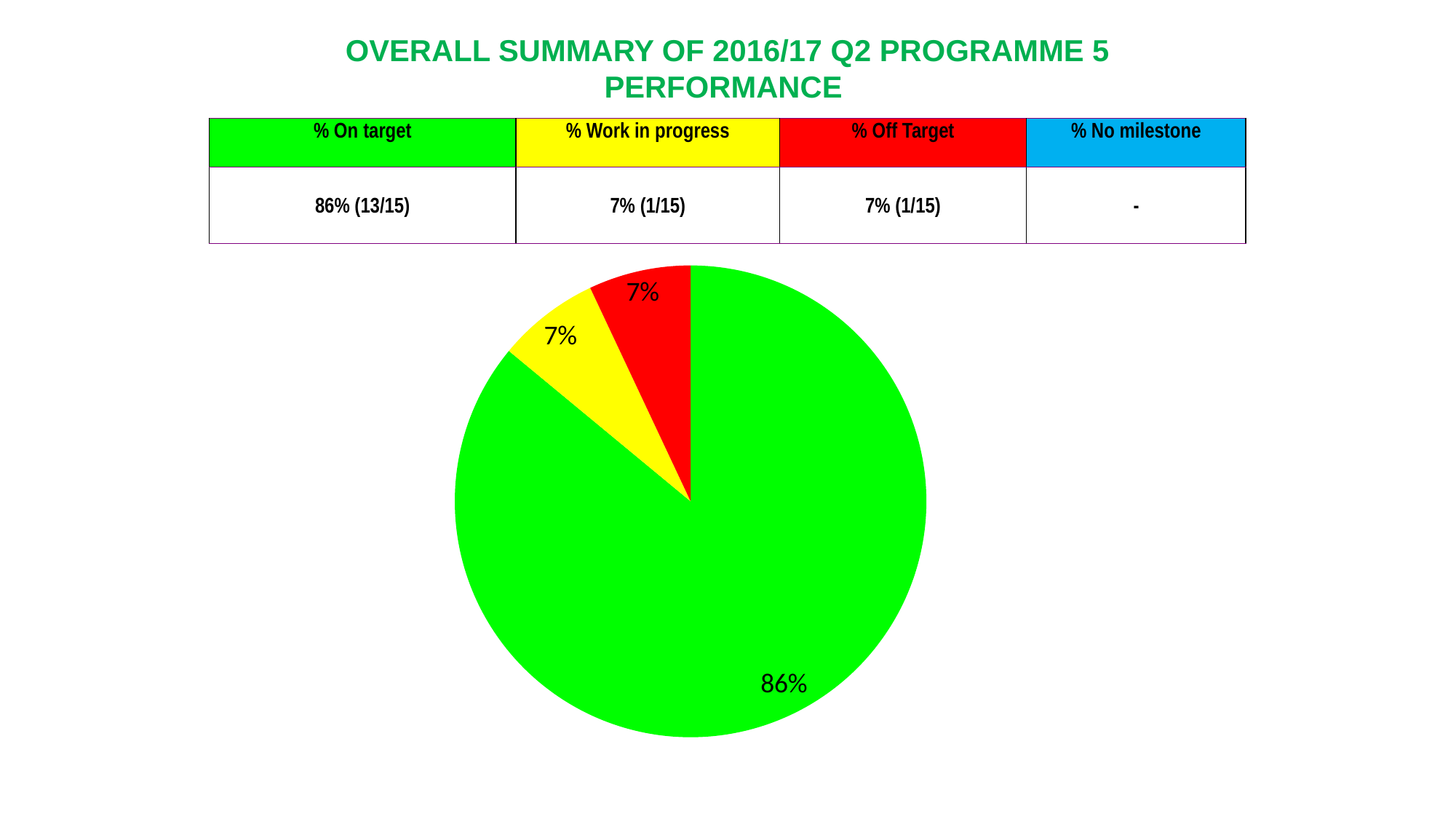
What share of the pie does the green slice represent? 86% What colour is used for the largest slice of the pie chart? green What is the difference between the green slice's share and the yellow slice's share? 79% According to the table above the chart, what percentage of milestones is On target? 86% (13/15) What is the title shown at the top of the slide? OVERALL SUMMARY OF 2016/17 Q2 PROGRAMME 5 PERFORMANCE According to the table above the chart, what percentage of milestones is Off Target? 7% (1/15) How many slices does the pie chart have? 3 Is the green slice larger or smaller than the red slice? larger What kind of chart is shown on the slide? pie chart Which slice of the pie chart is the largest? the green slice (86%) What share of the pie does the red slice represent? 7% What share of the pie does the yellow slice represent? 7%